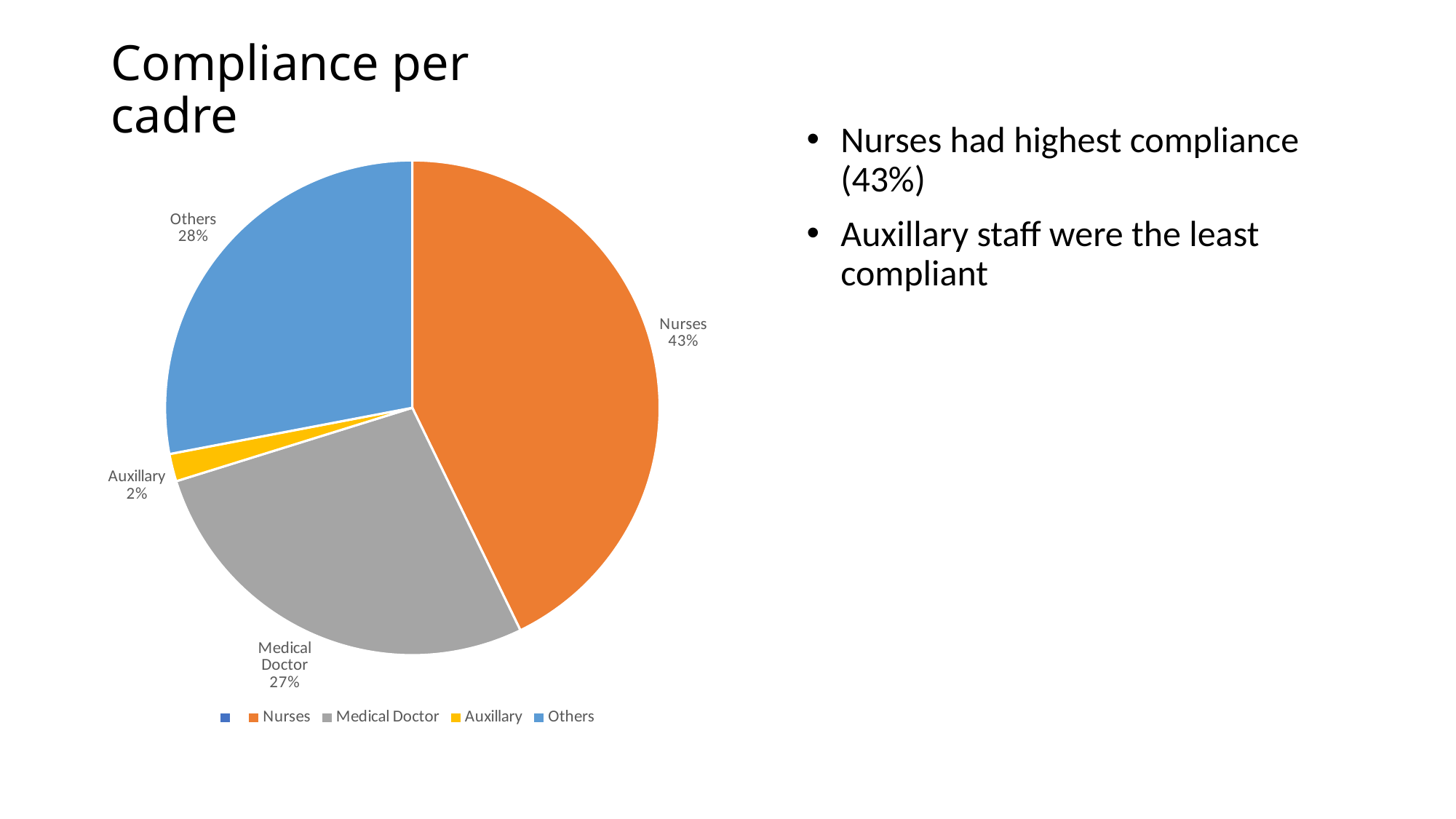
Which cadre has the largest slice of the pie? Nurses What percentage is shown for Medical Doctor? 27% What share of the pie does the Nurses slice represent? 43% What kind of chart is shown on the slide? pie chart What colour is the Nurses slice? orange Which is larger, the Others slice or the Medical Doctor slice? Others What percentage is shown for Others? 28% What is the difference in percentage points between Others and Auxillary? 26 Which cadre has the smallest slice of the pie? Auxillary How many labelled slices does the pie chart have? 4 What percentage is shown for Auxillary? 2% What is the difference in percentage points between Nurses and Medical Doctor? 16